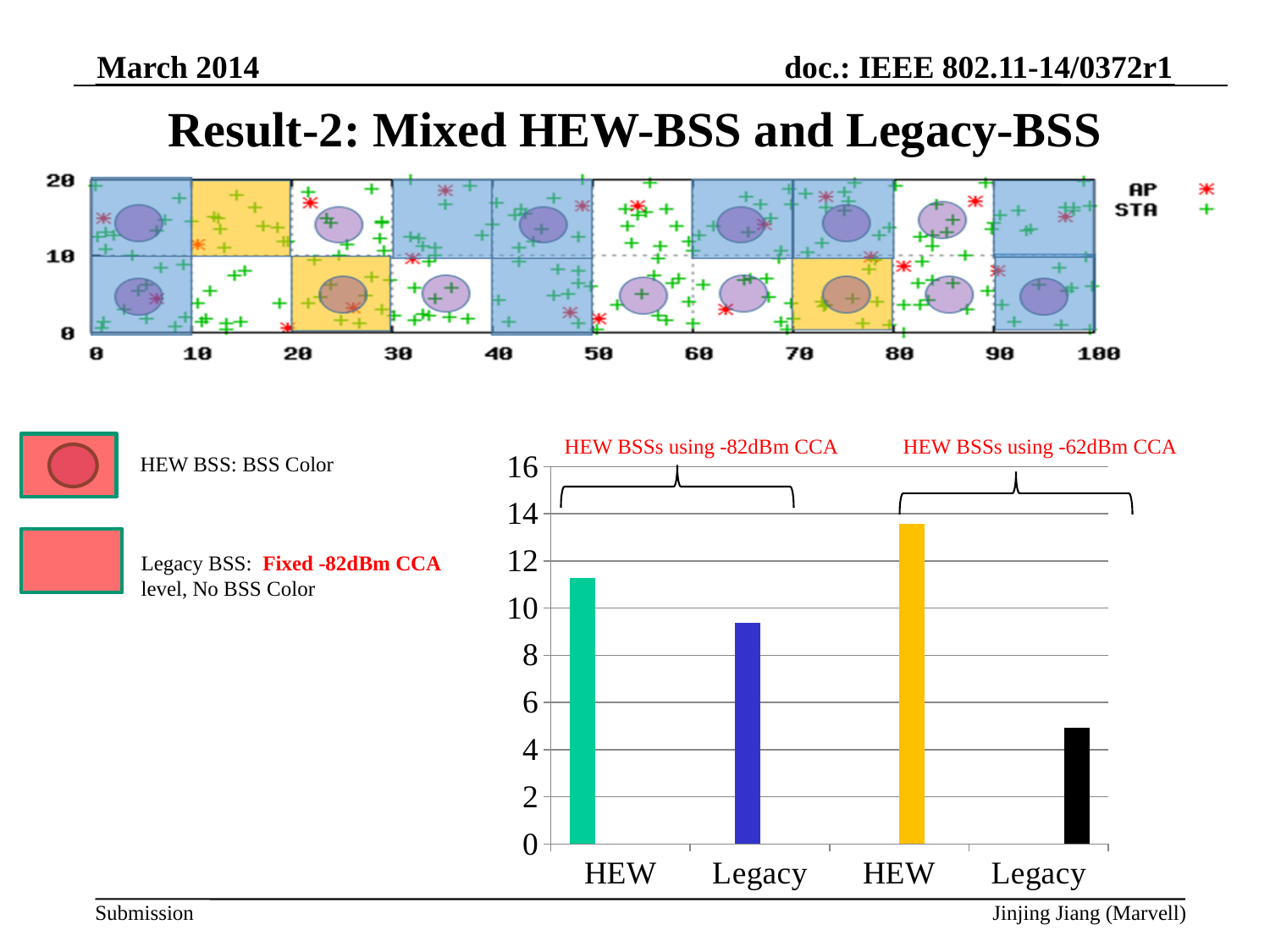
In the bar chart, which Legacy bar is larger: the one under -82dBm CCA or the one under -62dBm CCA? the one under -82dBm CCA In the bar chart, which is larger: the HEW bar or the Legacy bar under 'HEW BSSs using -82dBm CCA'? HEW What colour is the HEW bar under 'HEW BSSs using -62dBm CCA' in the bar chart? yellow In the bar chart, which bar is the tallest? HEW under HEW BSSs using -62dBm CCA In the bar chart, is the HEW bar under 'HEW BSSs using -82dBm CCA' greater or less than 10? greater How many bars are plotted in the bar chart? 4 In the bar chart, is the HEW bar under 'HEW BSSs using -62dBm CCA' greater or less than 12? greater What is the highest value shown on the vertical axis of the bar chart? 16 In the bar chart, is the Legacy bar under 'HEW BSSs using -62dBm CCA' greater or less than 6? less What kind of chart is shown at the bottom right of the slide? bar chart In the bar chart, which bar is the shortest? Legacy under HEW BSSs using -62dBm CCA